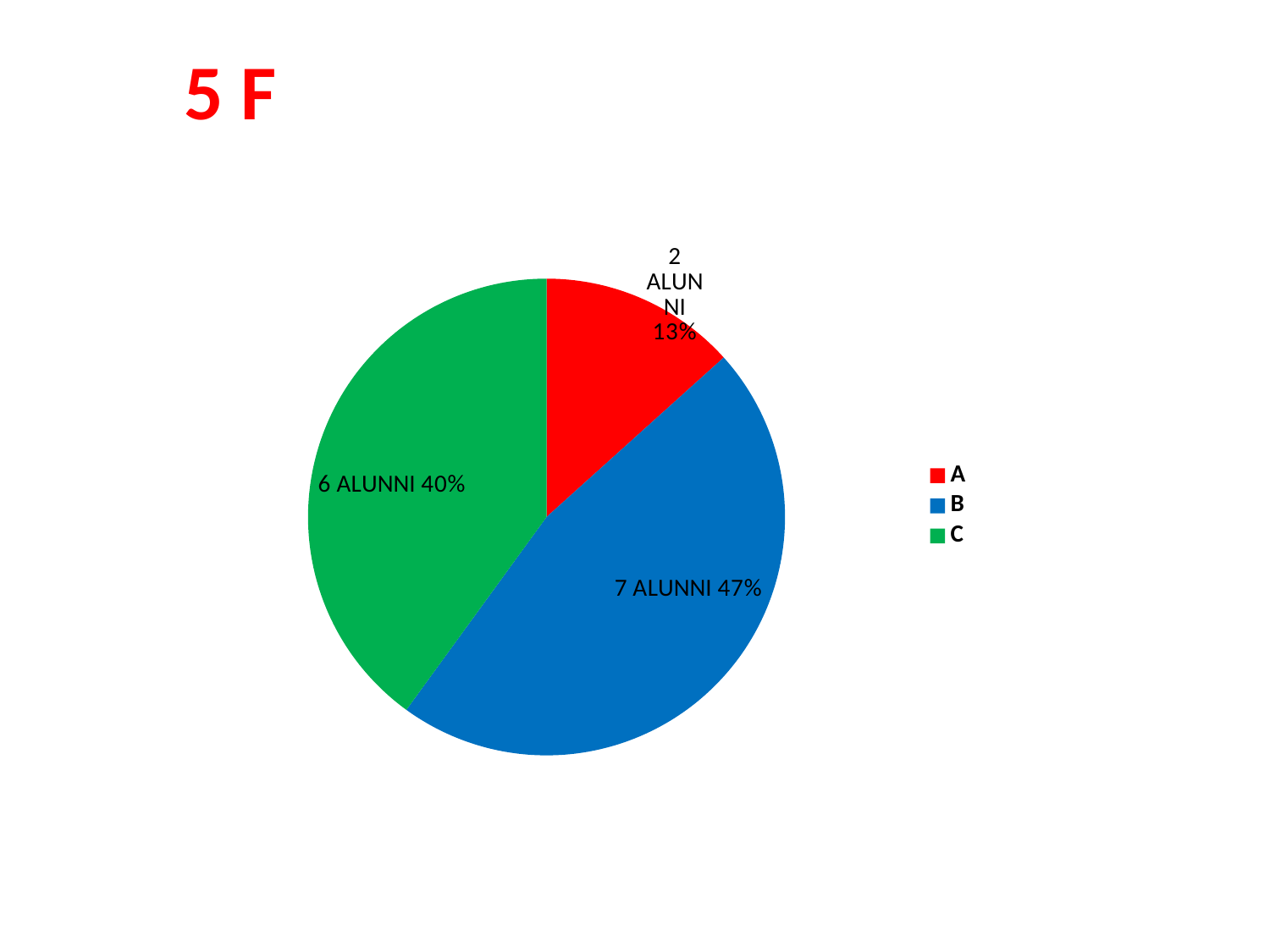
What percentage share does slice B have? 47% What kind of chart is shown on the slide? pie chart How many alunni are in category B? 7 Which category has the largest slice? B How many slices does the pie chart have? 3 What percentage share does slice C have? 40% Which category has the smallest slice? A What is the difference in number of alunni between category B and category A? 5 How many alunni are in category C? 6 How many entries does the legend list? 3 What percentage share does slice A have? 13% How many alunni are in category A? 2